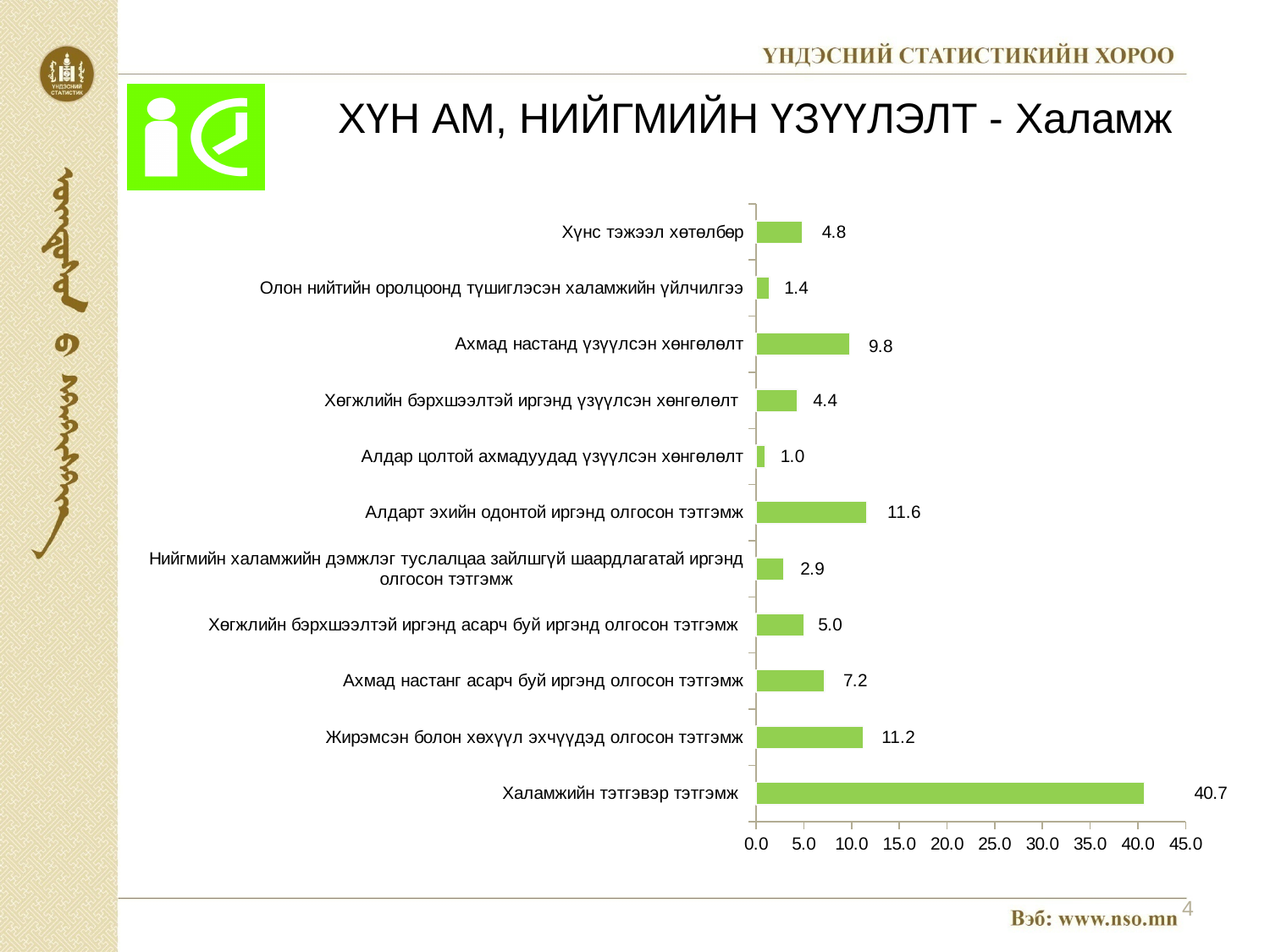
What is the value for Ахмад настанд үзүүлсэн хөнгөлөлт? 9.8 Which is larger: the value for Хөгжлийн бэрхшээлтэй иргэнд асарч буй иргэнд олгосон тэтгэмж or the value for Хөгжлийн бэрхшээлтэй иргэнд үзүүлсэн хөнгөлөлт? Хөгжлийн бэрхшээлтэй иргэнд асарч буй иргэнд олгосон тэтгэмж What is the value for Халамжийн тэтгэвэр тэтгэмж? 40.7 Is the value for Халамжийн тэтгэвэр тэтгэмж greater or less than 40.0? greater Which category has the highest value? Халамжийн тэтгэвэр тэтгэмж What is the difference between the values for Алдарт эхийн одонтой иргэнд олгосон тэтгэмж and Жирэмсэн болон хөхүүл эхчүүдэд олгосон тэтгэмж? 0.4 What is the value for Жирэмсэн болон хөхүүл эхчүүдэд олгосон тэтгэмж? 11.2 What is the title of the slide? ХҮН АМ, НИЙГМИЙН ҮЗҮҮЛЭЛТ - Халамж Which category has the lowest value? Алдар цолтой ахмадуудад үзүүлсэн хөнгөлөлт What kind of chart is shown on the slide? Bar chart What is the difference between the values for Ахмад настанг асарч буй иргэнд олгосон тэтгэмж and Хүнс тэжээл хөтөлбөр? 2.4 How many categories are shown in the chart? 11